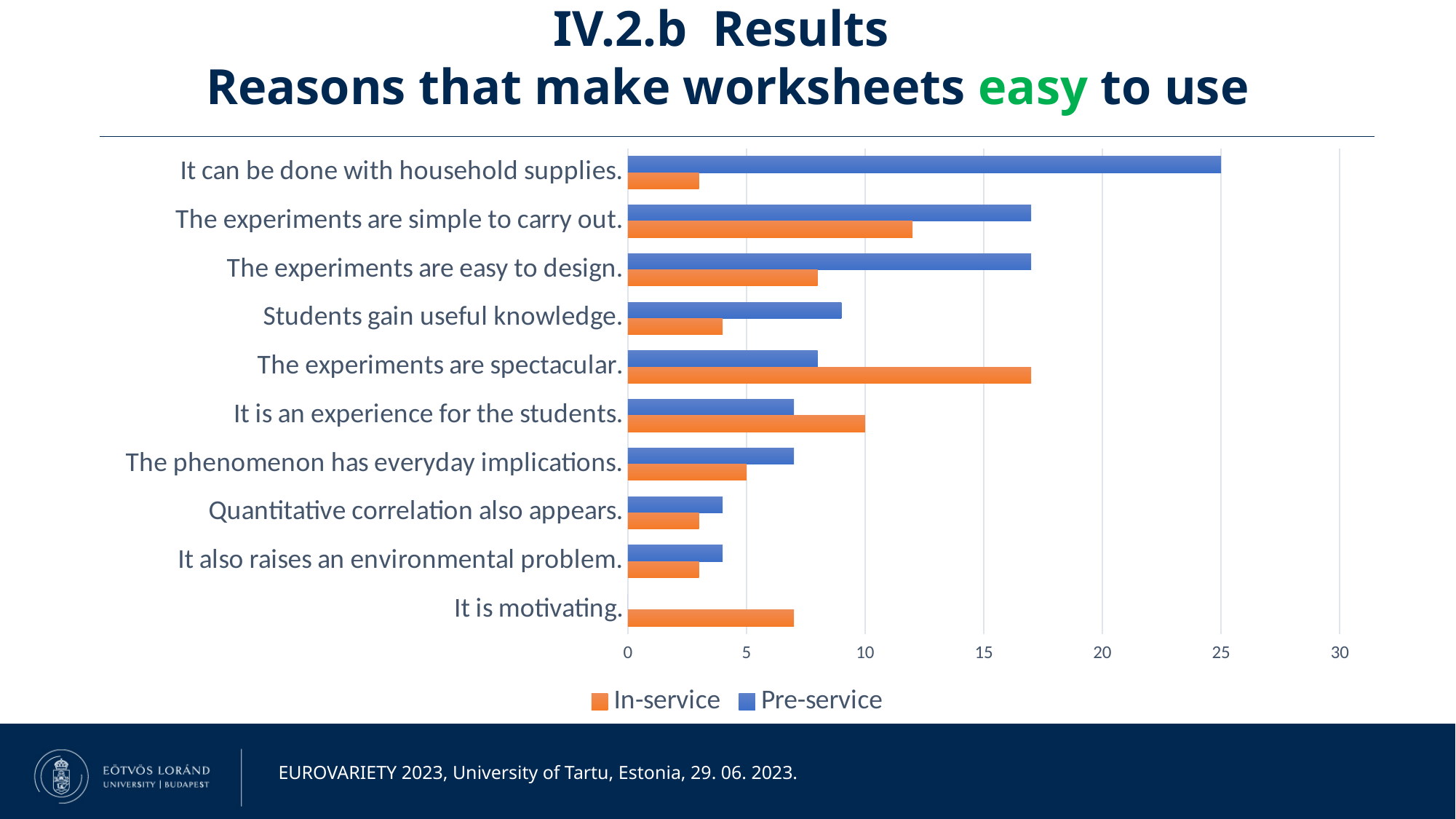
For "The experiments are spectacular.", which series has the larger value, In-service or Pre-service? In-service Is the Pre-service value for "The experiments are simple to carry out." greater or less than 15? greater How many series does the legend list? 2 Which reason has the highest In-service value? The experiments are spectacular. Which reason has the lowest Pre-service value? It is motivating. How many reasons (categories) are plotted on the chart? 10 What is the In-service value for "The phenomenon has everyday implications."? 5 What is the In-service value for "It is an experience for the students."? 10 Which colour represents the In-service series in the legend? orange What is the Pre-service value for "It can be done with household supplies."? 25 What type of chart is shown on the slide? bar chart Which reason has the highest Pre-service value? It can be done with household supplies.